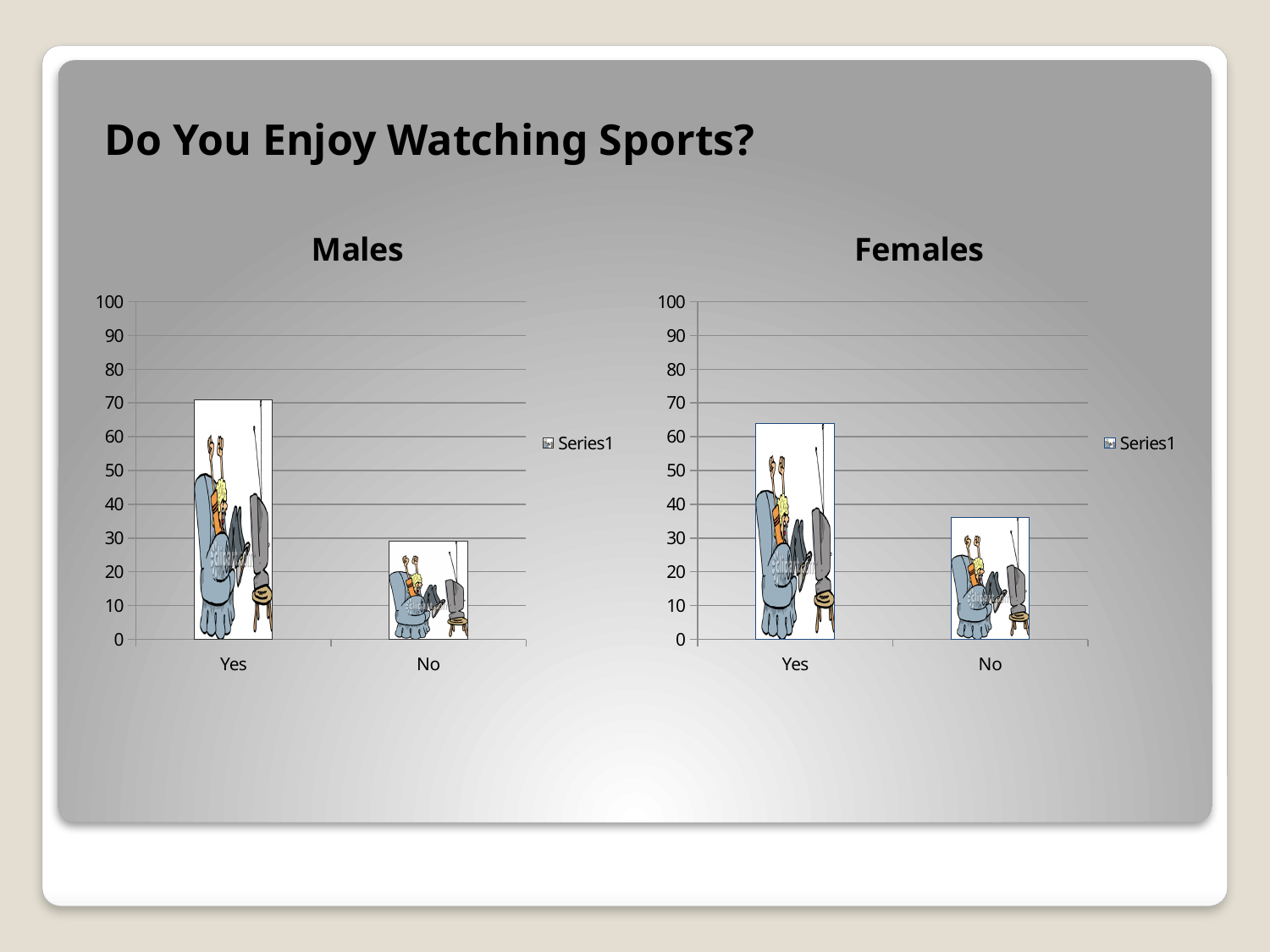
In the Females chart, which category has the lower value? No How many series does the legend of the Males chart list? 1 In the Females chart, is the value for No greater or less than 50? less In the Males chart, is the value for Yes greater or less than 60? greater What kind of chart is the Females chart? bar chart How many categories are shown on the x axis of the Males chart? 2 In the Females chart, is the value for Yes greater or less than 50? greater What is the title of the chart on the right side of the slide? Females Is the No value in the Females chart larger or smaller than the No value in the Males chart? larger In the Males chart, which category has the higher value, Yes or No? Yes Is the Yes value in the Males chart larger or smaller than the Yes value in the Females chart? larger